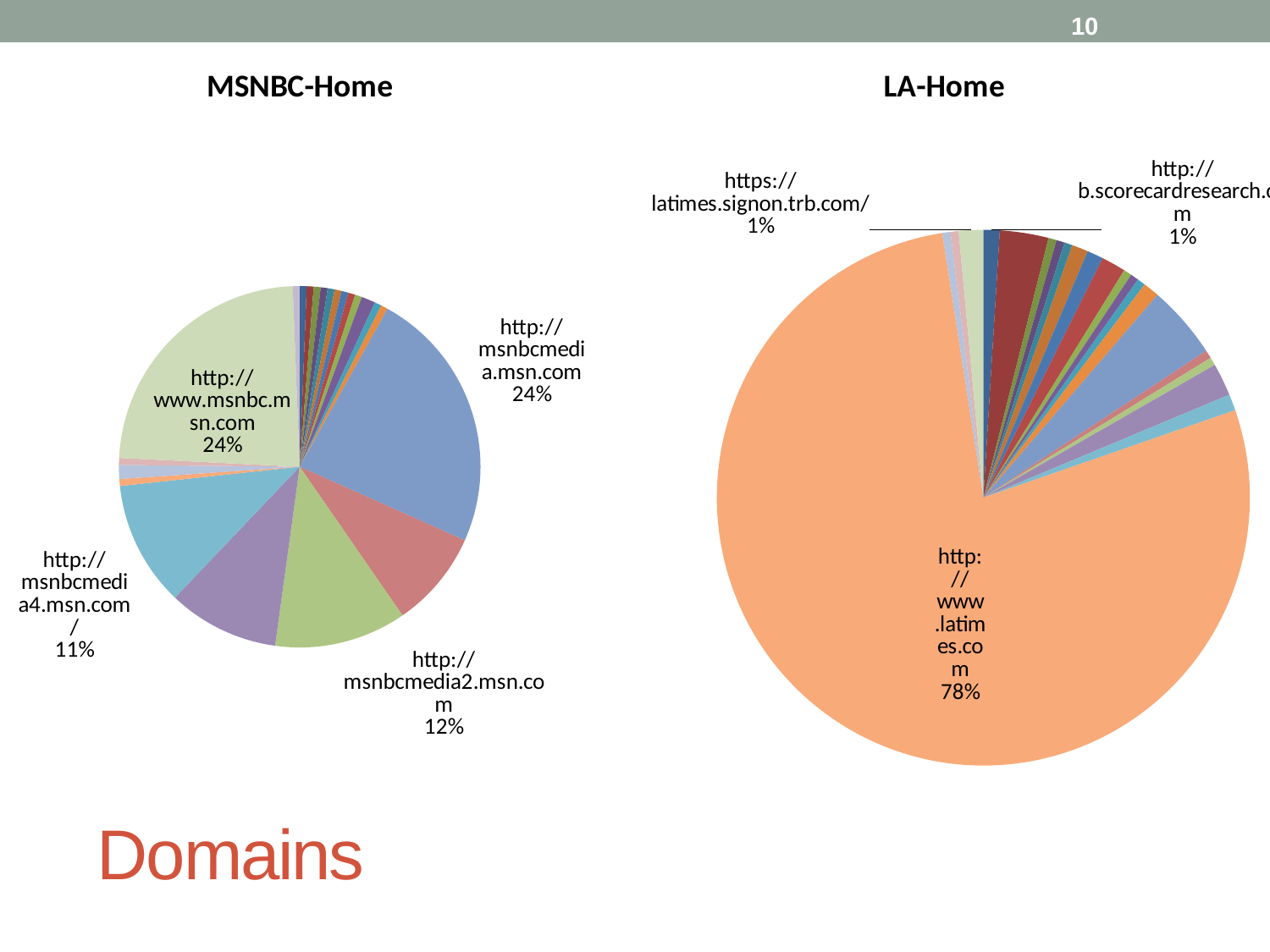
In the MSNBC-Home chart, what is the difference in percentage points between http://msnbcmedia2.msn.com and http://msnbcmedia4.msn.com/? 1 percentage point In the LA-Home chart, what share does https://latimes.signon.trb.com/ have? 1% In the MSNBC-Home chart, what share does http://msnbcmedia.msn.com have? 24% In the LA-Home chart, what share does http://www.latimes.com have? 78% What kind of chart is the LA-Home chart? Pie chart What are the titles of the two pie charts on the slide? MSNBC-Home and LA-Home In the LA-Home chart, which domain has the largest slice? http://www.latimes.com What kind of chart is the MSNBC-Home chart? Pie chart In the MSNBC-Home chart, which is larger: the slice for http://msnbcmedia2.msn.com or the slice for http://msnbcmedia4.msn.com/? http://msnbcmedia2.msn.com